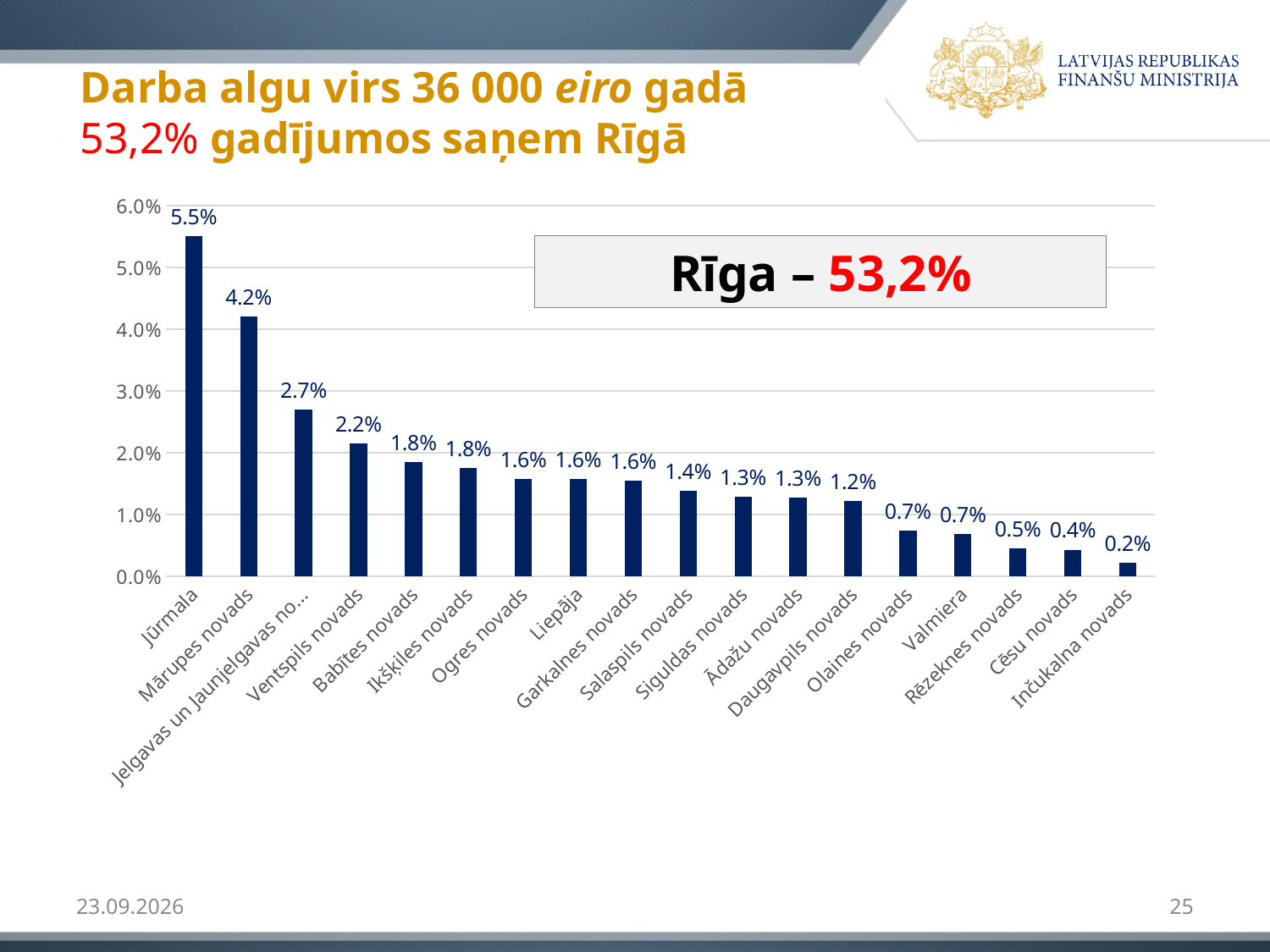
What is the value for Jūrmala? 5.5% What percentage is given for Rīga in the box on the chart? 53,2% How many categories are shown on the x axis? 18 Which is larger, the value for Siguldas novads or the value for Cēsu novads? Siguldas novads Which category has the highest value? Jūrmala What is the value for Ventspils novads? 2.2% Which category has the lowest value? Inčukalna novads What is the difference between the values for Jūrmala and Mārupes novads? 1.3% Do the values rise or fall from left to right along the x axis? Fall What is the value for Olaines novads? 0.7% What kind of chart is shown on the slide? Bar chart What is the value for Mārupes novads? 4.2%